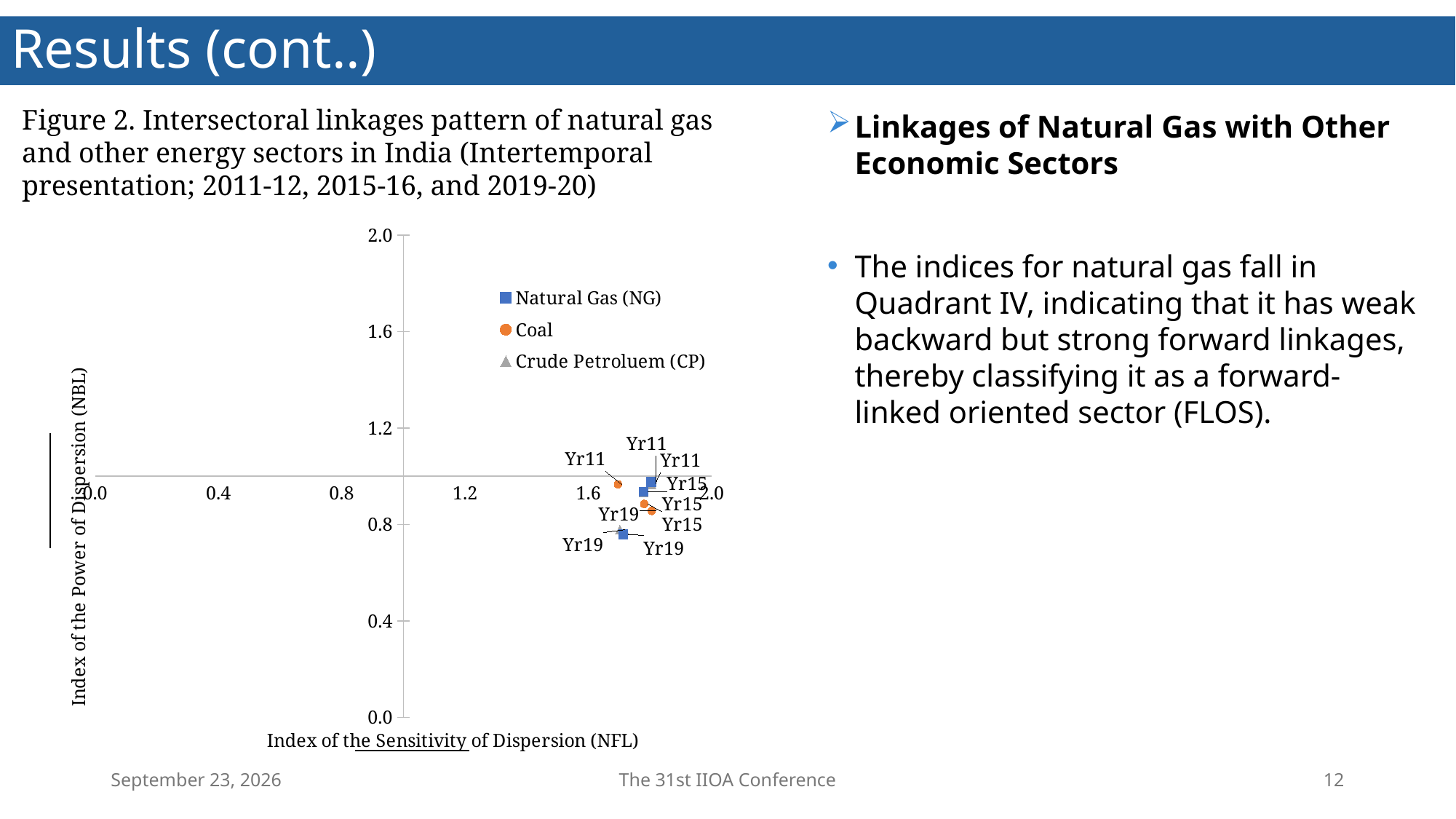
Is the NBL (y-axis) value for the Coal Yr15 point greater or less than 1.2? less How many series does the chart legend list? 3 Is the NFL (x-axis) value for the Coal Yr11 point greater or less than 1.6? greater Which series are listed in the chart legend? Natural Gas (NG), Coal, Crude Petroluem (CP) What kind of chart is shown on the slide? scatter chart What is the highest value shown on the chart's vertical axis? 2.0 Does the NBL (y-axis) value for Natural Gas rise or fall from Yr11 to Yr19? fall Is the NBL (y-axis) value for the Natural Gas Yr19 point greater or less than 1.2? less What is the title of the chart's vertical axis? Index of the Power of Dispersion (NBL) Which Natural Gas point has the higher NBL (y-axis) value, Yr11 or Yr19? Yr11